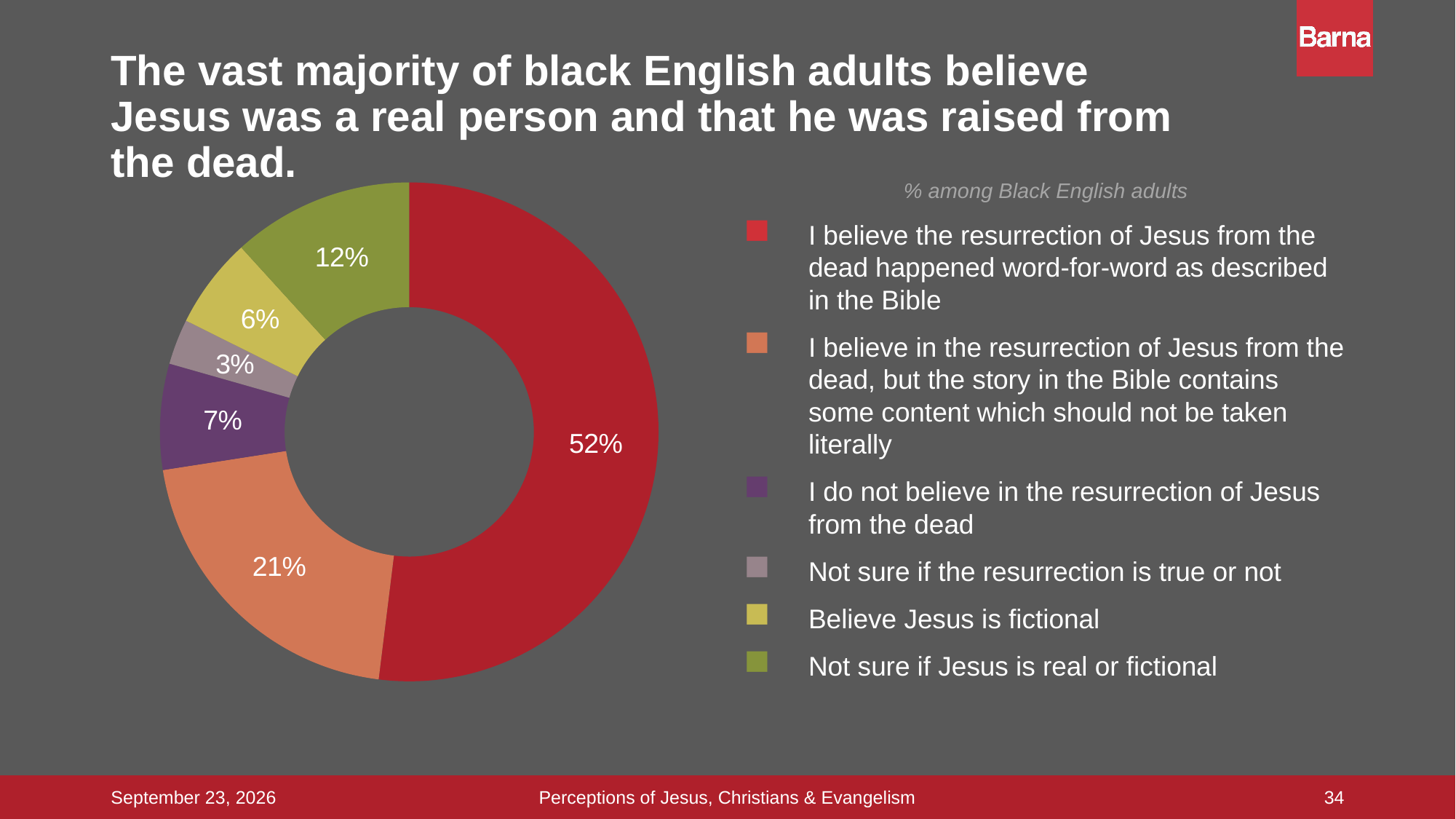
Which is larger: the share who believe Jesus is fictional or the share who are not sure if Jesus is real or fictional? Not sure if Jesus is real or fictional What is the difference in percentage points between those who believe the resurrection happened word-for-word and those who believe it but not literally? 31 What percentage of Black English adults do not believe in the resurrection of Jesus from the dead? 7% What percentage of Black English adults believe the resurrection of Jesus from the dead happened word-for-word as described in the Bible? 52% What percentage of Black English adults believe Jesus is fictional? 6% How many categories does the legend list? 6 What kind of chart is shown on the slide? Pie chart (doughnut) What percentage of Black English adults are not sure if the resurrection is true or not? 3% What percentage of Black English adults are not sure if Jesus is real or fictional? 12% What percentage of Black English adults believe in the resurrection but think the Bible story contains content which should not be taken literally? 21% Which response has the largest share of the pie? I believe the resurrection of Jesus from the dead happened word-for-word as described in the Bible Which response has the smallest share of the pie? Not sure if the resurrection is true or not